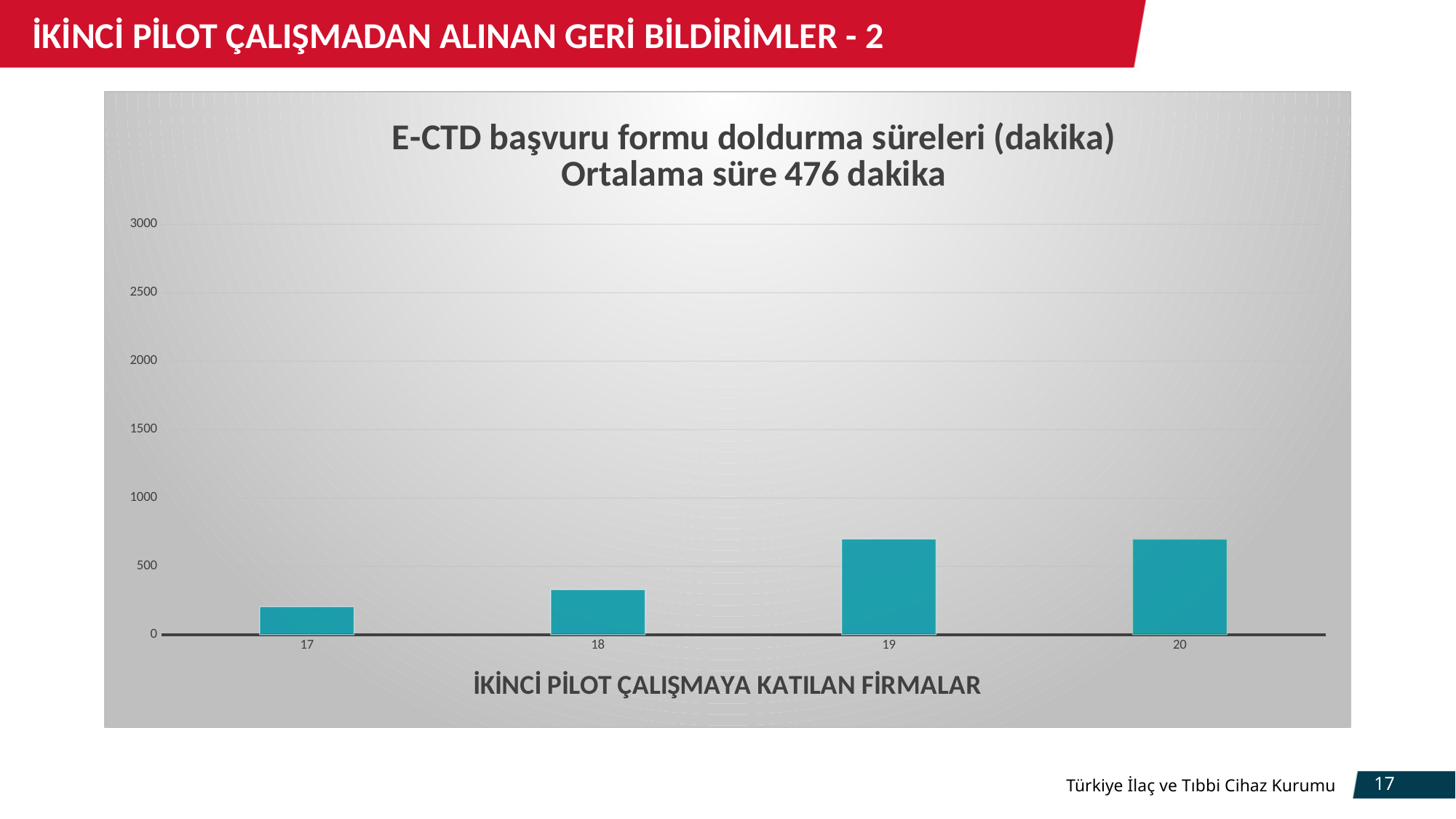
Is the value for firm 17 greater or less than 500? less What kind of chart is shown on the slide? bar chart Which has a larger value, firm 17 or firm 18? 18 What average time (ortalama süre) is stated in the chart title? 476 dakika Is the value for firm 18 greater or less than 500? less What is the title of the x axis of the chart? İKİNCİ PİLOT ÇALIŞMAYA KATILAN FİRMALAR Which firm has the lowest form-filling time in the chart? 17 Which has a larger value, firm 18 or firm 20? 20 Is the value for firm 19 greater or less than 500? greater How many firms (categories) are shown on the x axis of the chart? 4 Do the values rise or fall from firm 17 to firm 19? rise